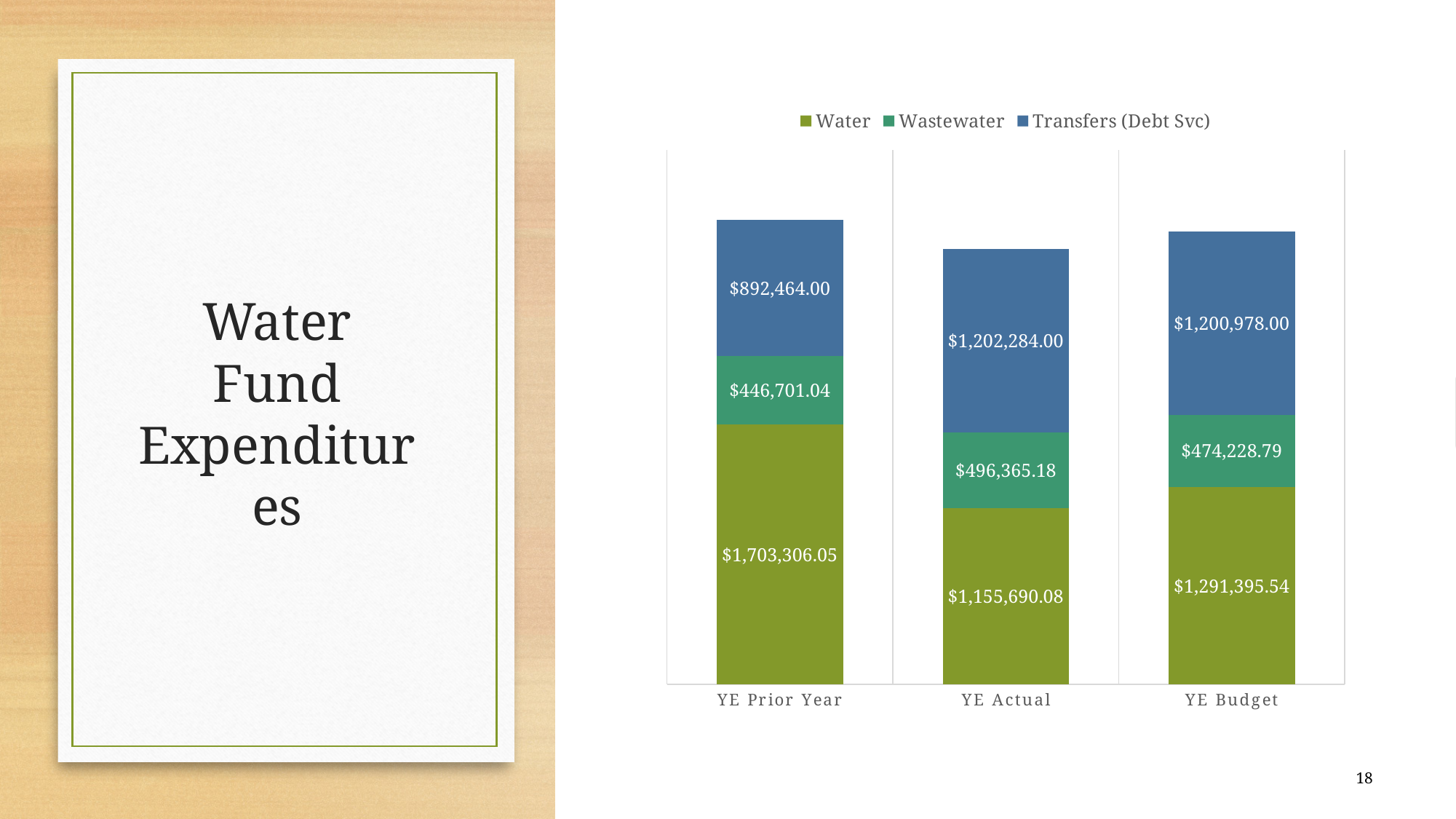
What is the difference between the Wastewater values for YE Actual and YE Budget? $22,136.39 How many series does the legend list? 3 Which category has the lowest Wastewater value? YE Prior Year What kind of chart is shown on the slide? Stacked bar chart How many categories are shown on the x axis? 3 Which category has the highest Water value? YE Prior Year What is the Transfers (Debt Svc) value for YE Actual? $1,202,284.00 What is the total of the stacked bar for YE Prior Year? $3,042,471.09 Which is larger, the Transfers (Debt Svc) value for YE Prior Year or for YE Actual? YE Actual What is the difference between the Water values for YE Prior Year and YE Actual? $547,615.97 What is the Water value for YE Prior Year? $1,703,306.05 What is the Wastewater value for YE Budget? $474,228.79